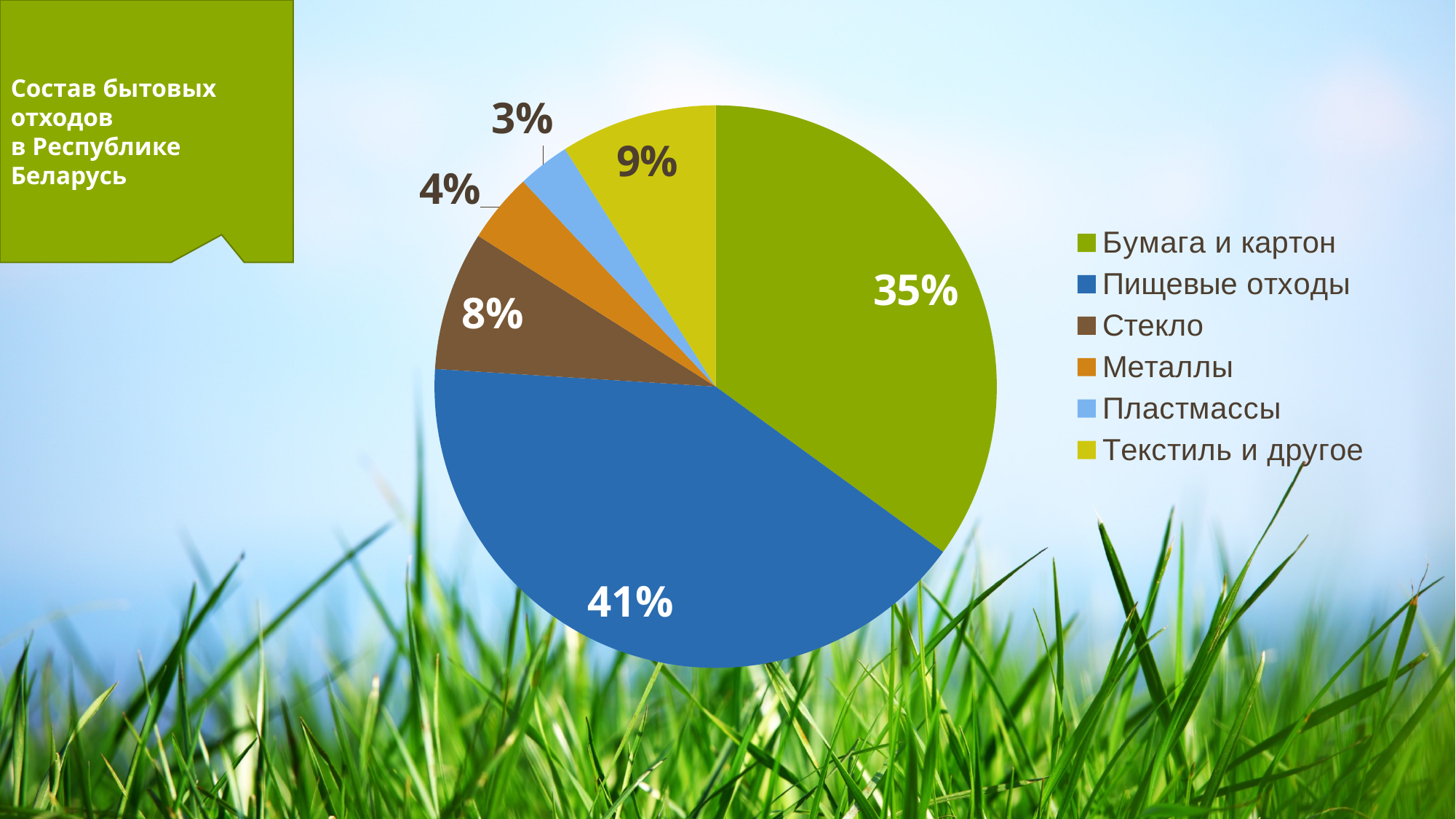
What share of the pie does Пищевые отходы have? 41% What share of the pie does Бумага и картон have? 35% What is the difference between the shares of Пищевые отходы and Бумага и картон? 6% What is the value shown for Пластмассы? 3% Which category has the largest slice of the pie? Пищевые отходы What kind of chart is shown on the slide? Pie chart How many categories does the pie chart show? 6 Which is larger, the share for Стекло or the share for Текстиль и другое? Текстиль и другое What is the value shown for Текстиль и другое? 9% What is the value shown for Стекло? 8% What is the value shown for Металлы? 4% Which category has the smallest slice of the pie? Пластмассы